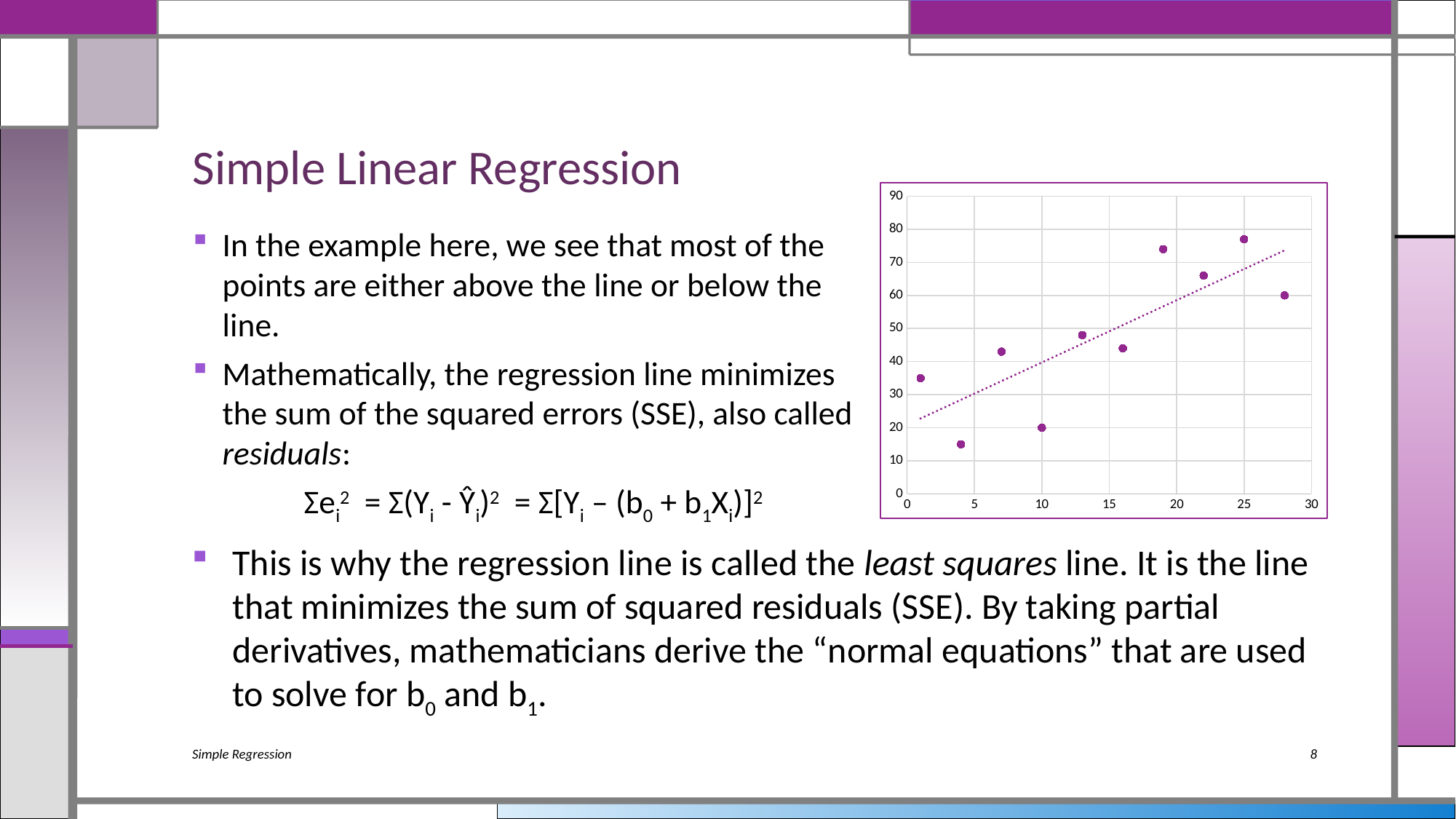
Is the y value of the point at x = 1 greater or less than 30? greater What is the highest value shown on the horizontal axis of the chart? 30 Which has the larger y value, the point at x = 22 or the point at x = 28? the point at x = 22 Is the y value of the point at x = 10 greater or less than 30? less What kind of chart is shown on the slide? scatter plot Do the plotted values generally rise or fall as the x value increases? rise What is the highest value shown on the vertical axis of the chart? 90 Is the y value of the point at x = 28 greater or less than 50? greater Which has the larger y value, the point at x = 4 or the point at x = 10? the point at x = 10 How many data points are plotted in the scatter chart? 10